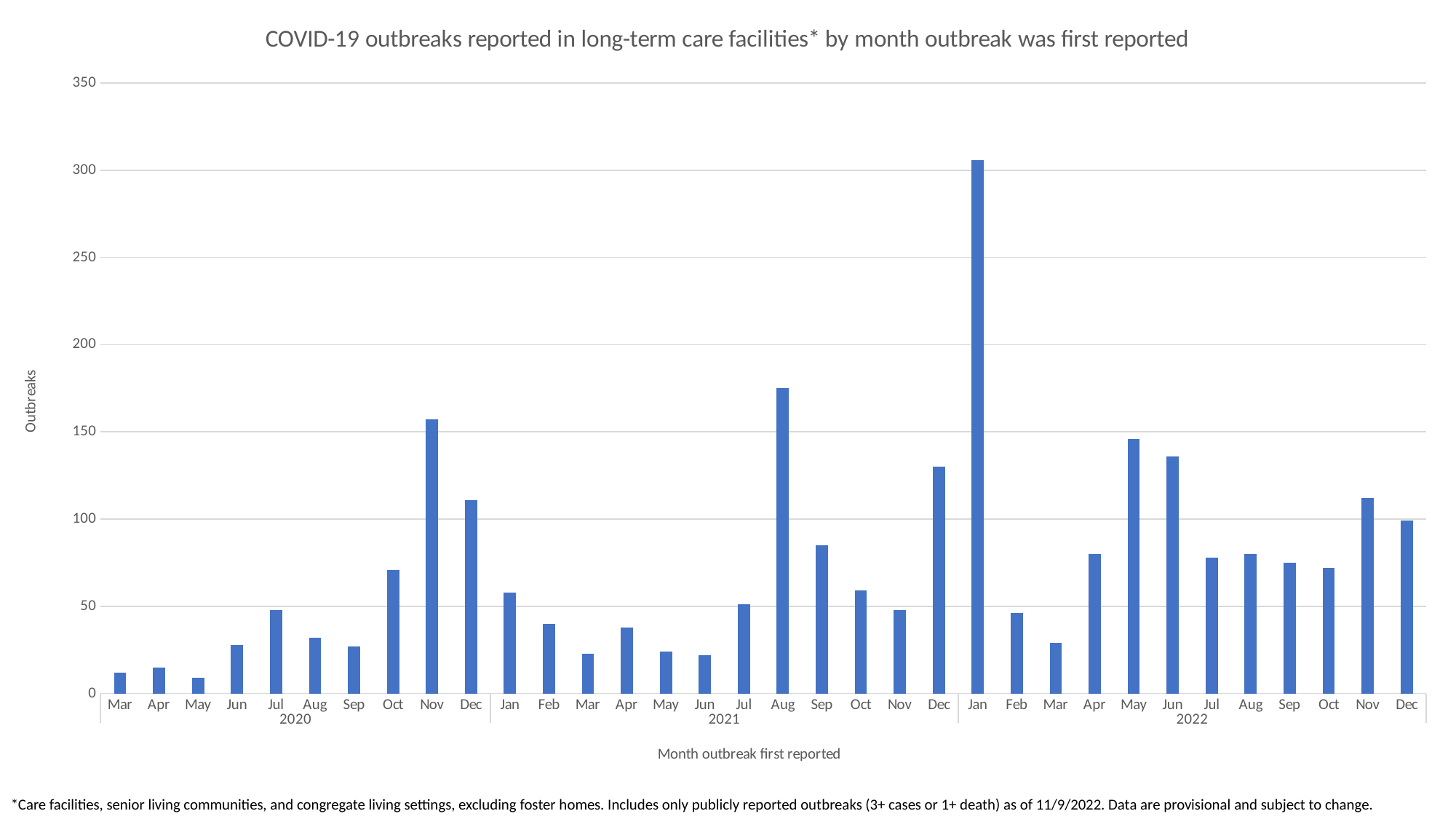
What kind of chart is shown on the slide? Bar chart Is the value for Sep 2021 greater or less than 100? less What is the title of the vertical axis? Outbreaks Is the value for Mar 2020 greater or less than 50? less How many monthly bars are plotted in the chart? 34 Which month has the highest number of outbreaks? Jan 2022 Is the value for Nov 2022 greater or less than 100? greater Which is larger, the value for Dec 2020 or the value for Dec 2021? Dec 2021 Which is larger, the value for Nov 2020 or the value for Aug 2021? Aug 2021 Do the values rise or fall from Jan 2022 to Mar 2022? fall